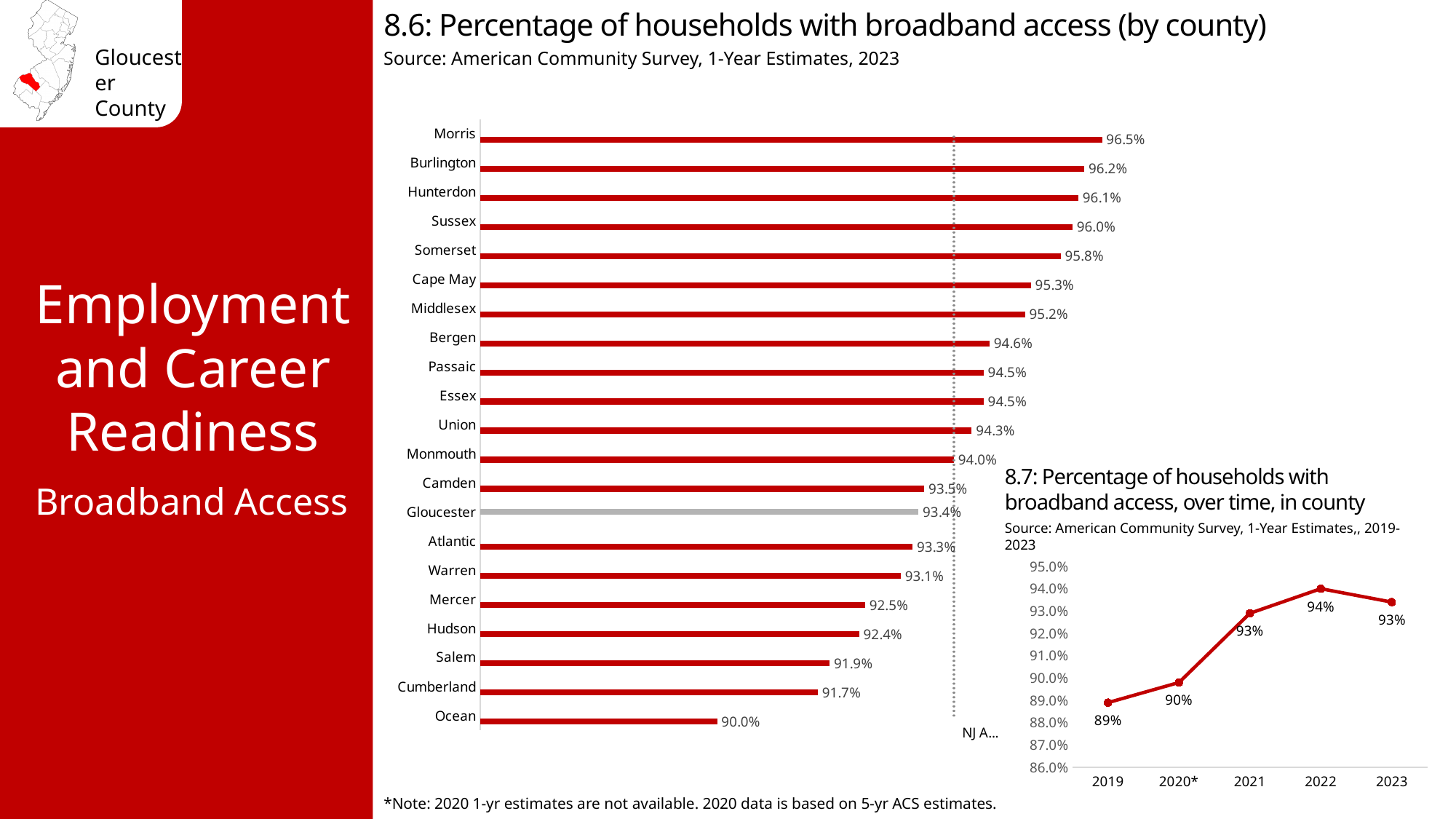
In the chart '8.6: Percentage of households with broadband access (by county)', which county has the highest value? Morris What kind of chart is '8.6: Percentage of households with broadband access (by county)'? Bar chart In the chart '8.6: Percentage of households with broadband access (by county)', what is the difference between the values for Morris and Gloucester? 3.1% What kind of chart is '8.7: Percentage of households with broadband access, over time, in county'? Line chart In the chart '8.6: Percentage of households with broadband access (by county)', what is the value for Ocean? 90.0% In the chart '8.6: Percentage of households with broadband access (by county)', which county's bar is shown in grey instead of red? Gloucester In the chart '8.6: Percentage of households with broadband access (by county)', which county has the lowest value? Ocean How many counties are shown in the chart '8.6: Percentage of households with broadband access (by county)'? 21 In the chart '8.6: Percentage of households with broadband access (by county)', what is the value for Gloucester? 93.4% In the chart '8.6: Percentage of households with broadband access (by county)', which has a higher value, Camden or Gloucester? Camden In the chart '8.7: Percentage of households with broadband access, over time, in county', what is the value for 2019? 89% In the chart '8.7: Percentage of households with broadband access, over time, in county', which year has the highest value? 2022